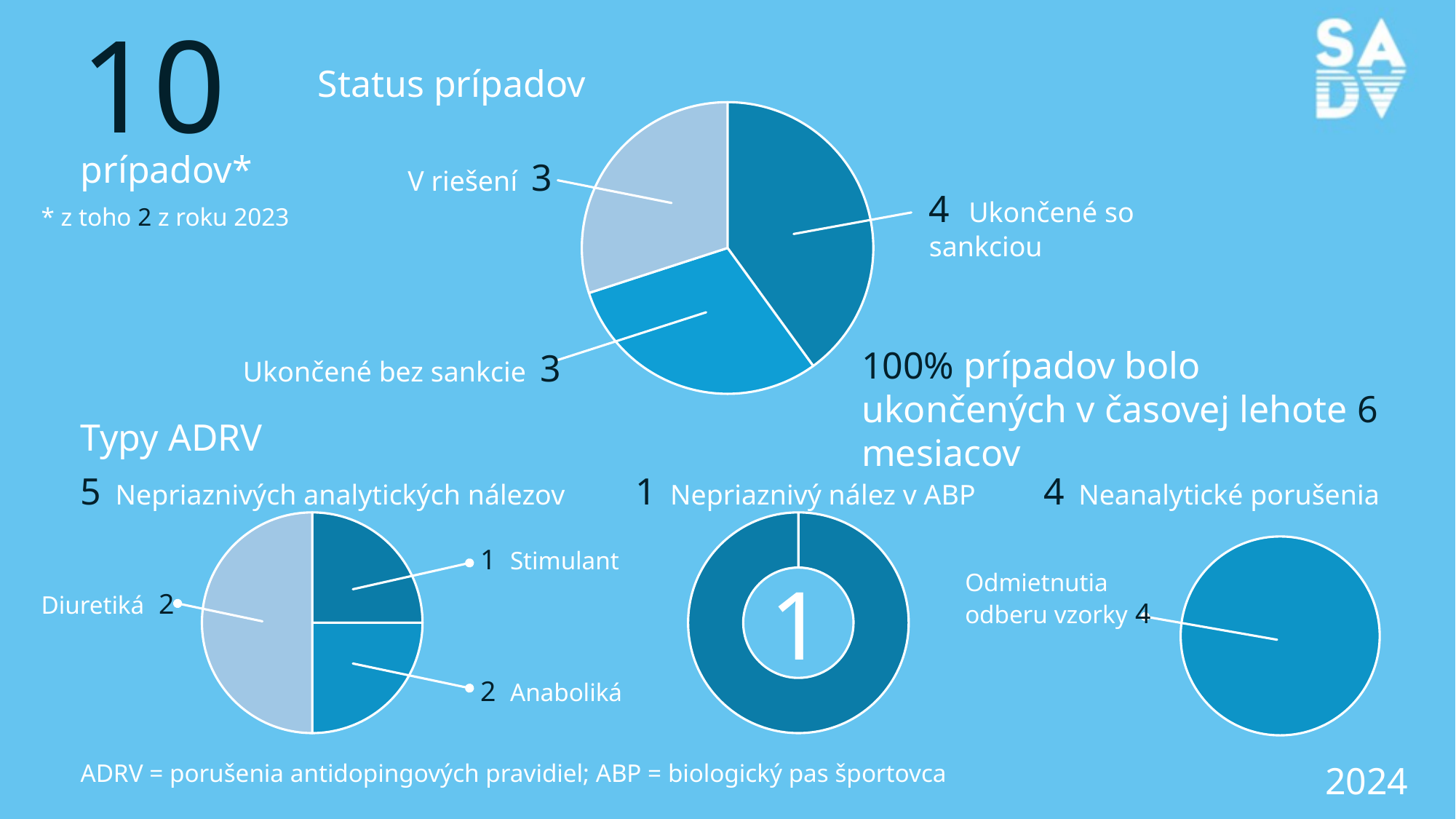
In the 'Status prípadov' pie chart, what is the value for 'Ukončené so sankciou'? 4 In the 'Nepriaznivých analytických nálezov' pie chart, which category has the lowest value? Stimulant In the 'Status prípadov' pie chart, what share of the total does 'Ukončené so sankciou' represent? 40% In the 'Status prípadov' pie chart, what is the total of all slices? 10 What kind of chart is used for 'Status prípadov'? pie chart In the 'Nepriaznivých analytických nálezov' pie chart, what is the value for 'Diuretiká'? 2 In the 'Nepriaznivých analytických nálezov' pie chart, what share of the total does 'Diuretiká' represent? 40% In the 'Neanalytické porušenia' chart, what is the value for 'Odmietnutia odberu vzorky'? 4 In the 'Nepriaznivých analytických nálezov' pie chart, what is the difference between 'Anaboliká' and 'Stimulant'? 1 In the 'Status prípadov' pie chart, what is the value for 'V riešení'? 3 In the 'Status prípadov' pie chart, which category has the highest value? Ukončené so sankciou In the 'Status prípadov' pie chart, how many slices are there? 3